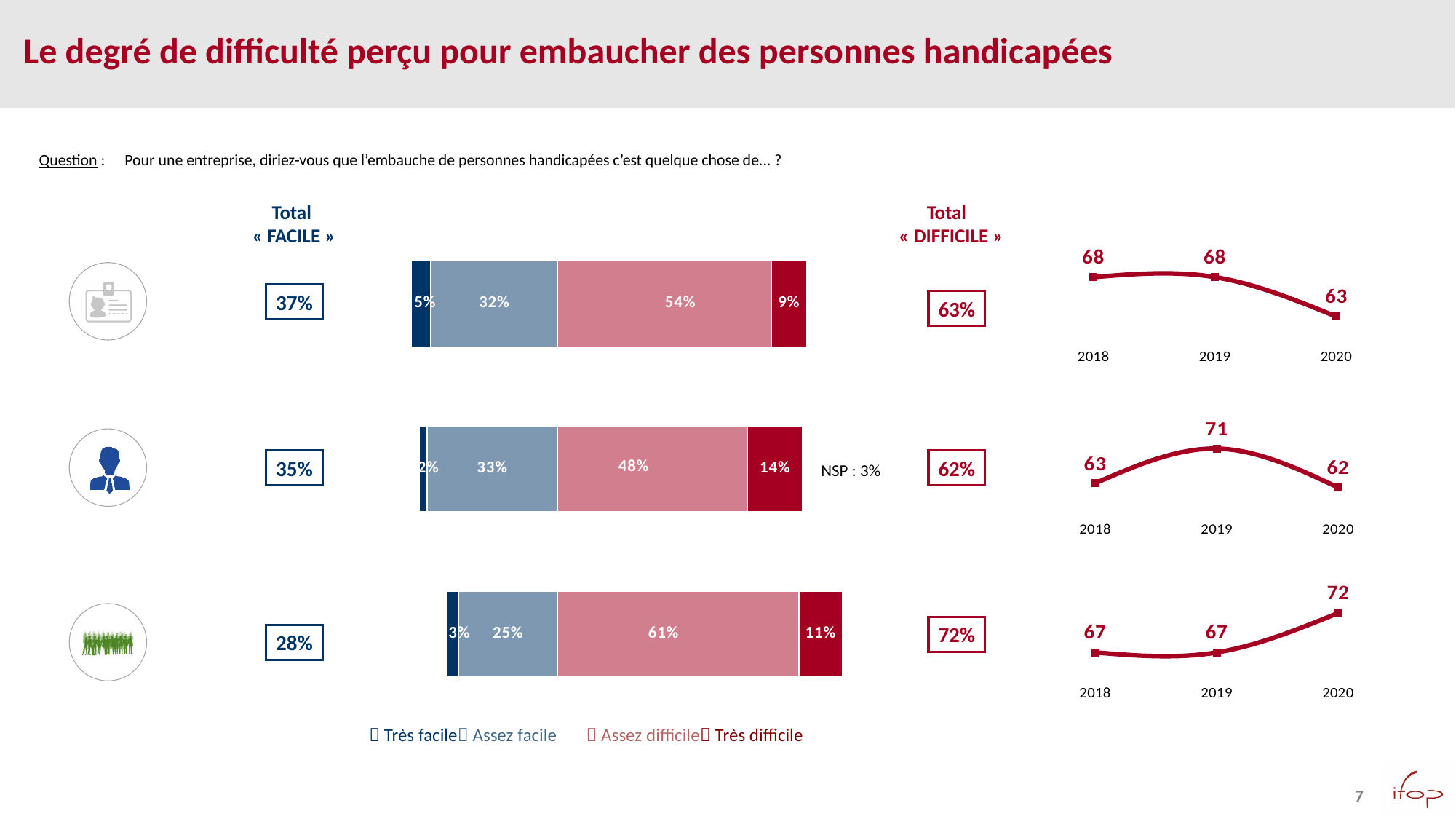
In the bottom row's stacked bar, what is the value for "Assez facile"? 25% What kind of chart is shown in the centre of each row? stacked bar chart In the top row's stacked bar, what is the value for "Assez difficile"? 54% In the top row's stacked bar, which is larger: the "Assez facile" segment or the "Très difficile" segment? Assez facile How many series does the legend of the stacked bars list? 4 In the top row's line chart, what is the value for 2020? 63 In the middle row's stacked bar, what is the value for "Très difficile"? 14% What is the Total « DIFFICILE » value shown for the bottom row? 72% How many years are plotted in each line chart on the right? 3 In the bottom row's line chart, do the values rise or fall from 2019 to 2020? rise In the bottom row's line chart, what is the difference between the 2020 value and the 2019 value? 5 In the middle row's line chart, which year has the highest value? 2019